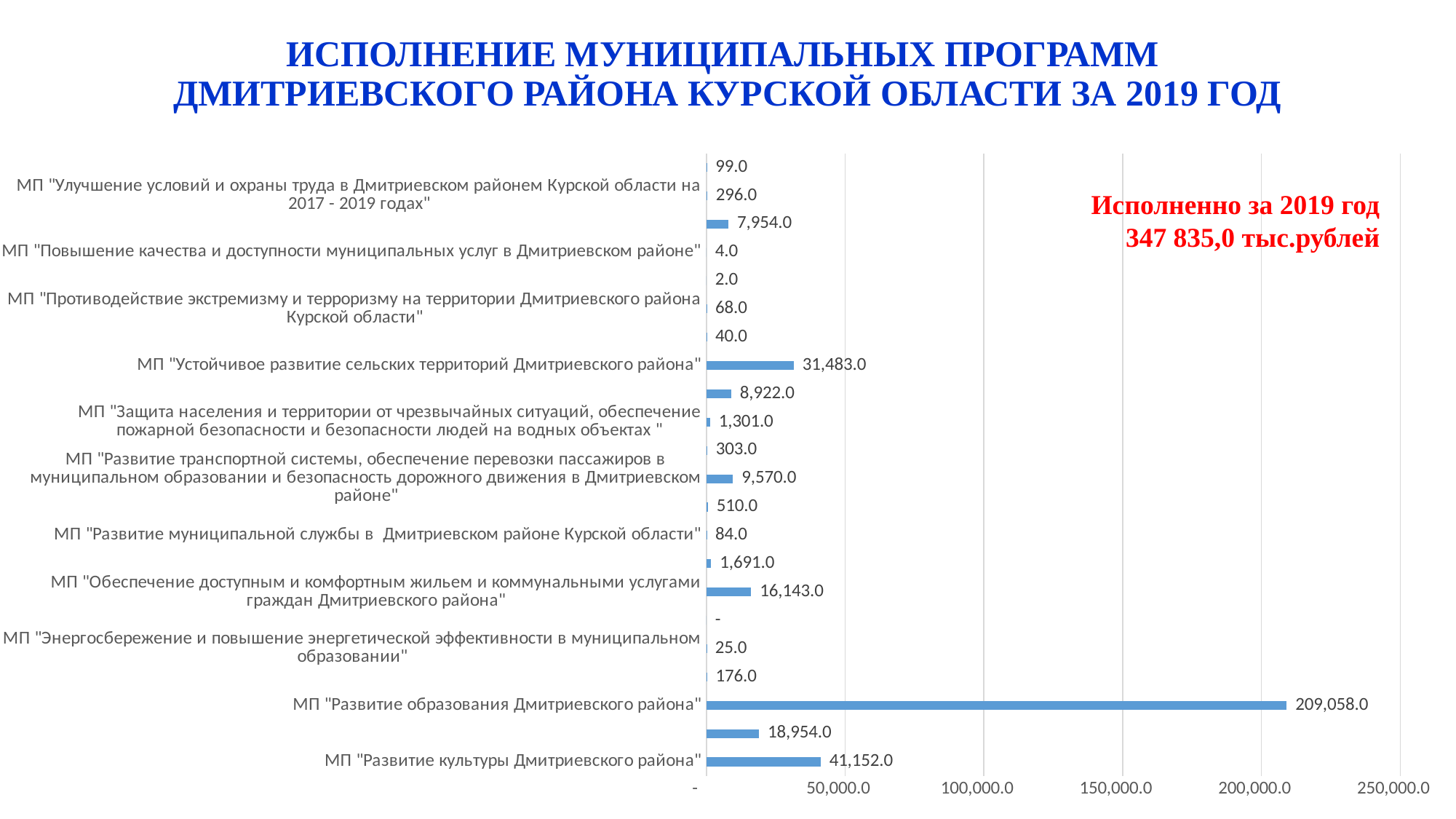
Which is larger: the value for МП "Развитие культуры Дмитриевского района" or for МП "Устойчивое развитие сельских территорий Дмитриевского района"? МП "Развитие культуры Дмитриевского района" Is the value for МП "Развитие образования Дмитриевского района" greater or less than 200,000.0? greater What kind of chart is shown on the slide? bar chart What is the value of the bar for МП "Развитие образования Дмитриевского района"? 209,058.0 What is the value of the bar for МП "Развитие муниципальной службы в Дмитриевском районе Курской области"? 84.0 What total executed amount for 2019 is stated in the red text on the slide? 347 835,0 тыс.рублей What is the difference between the values for МП "Развитие образования Дмитриевского района" and МП "Развитие культуры Дмитриевского района"? 167,906.0 How many program names are listed as category labels on the vertical axis? 11 What is the value of the bar for МП "Развитие культуры Дмитриевского района"? 41,152.0 Which program has the largest bar in the chart? МП "Развитие образования Дмитриевского района" What is the value of the bar for МП "Устойчивое развитие сельских территорий Дмитриевского района"? 31,483.0 Is the value for МП "Устойчивое развитие сельских территорий Дмитриевского района" greater or less than 50,000.0? less